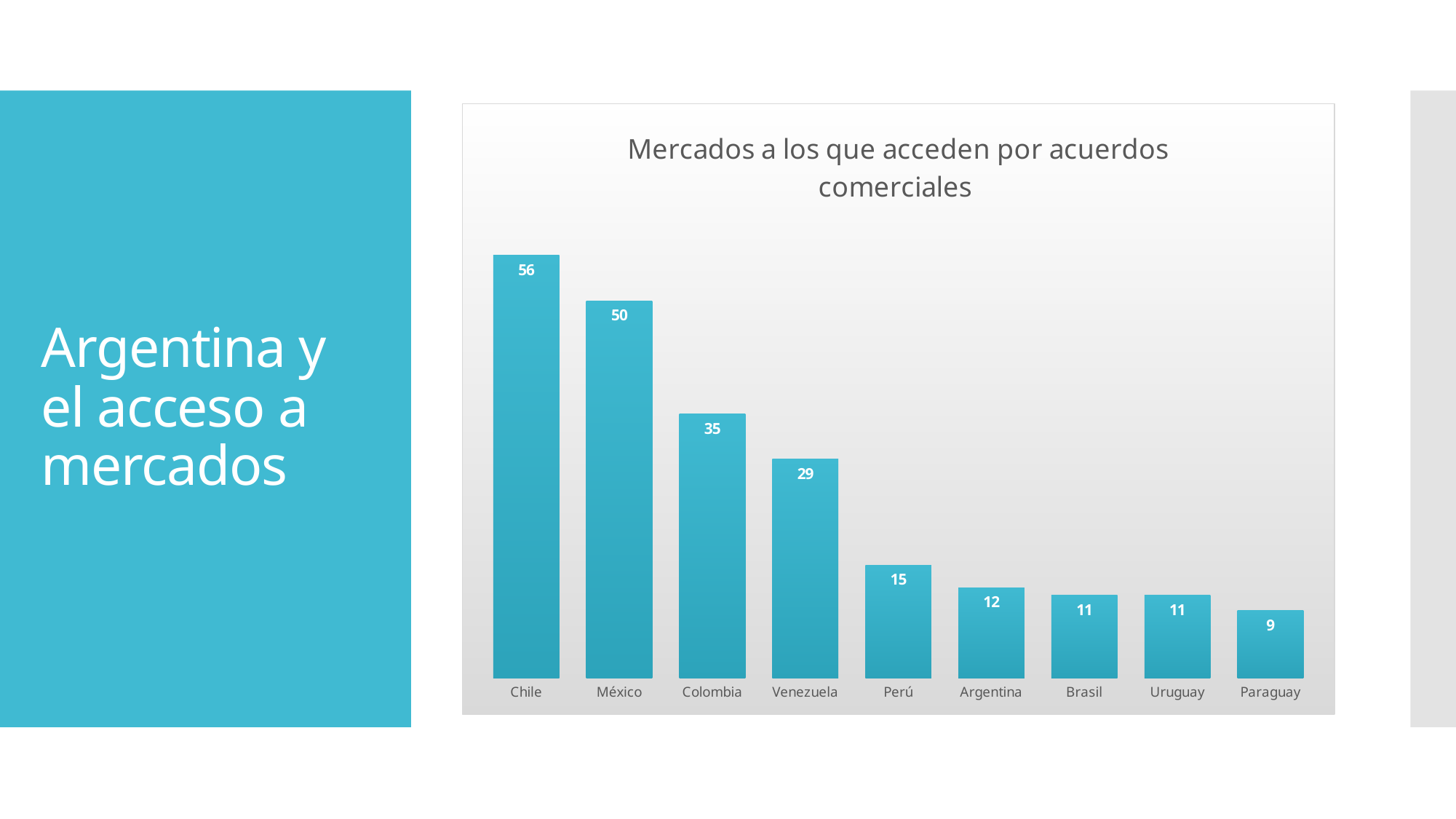
What kind of chart is shown on the slide? Bar chart How many countries are shown in the chart? 9 What is the value for Chile? 56 Do the values rise or fall from left to right across the chart? Fall Which is larger, the value for Perú or the value for Brasil? Perú What is the title of the chart? Mercados a los que acceden por acuerdos comerciales What is the value for Venezuela? 29 What is the difference between the values for Colombia and Argentina? 23 What is the difference between the values for Chile and México? 6 Which country has the highest value? Chile What is the value for Argentina? 12 Which country has the lowest value? Paraguay